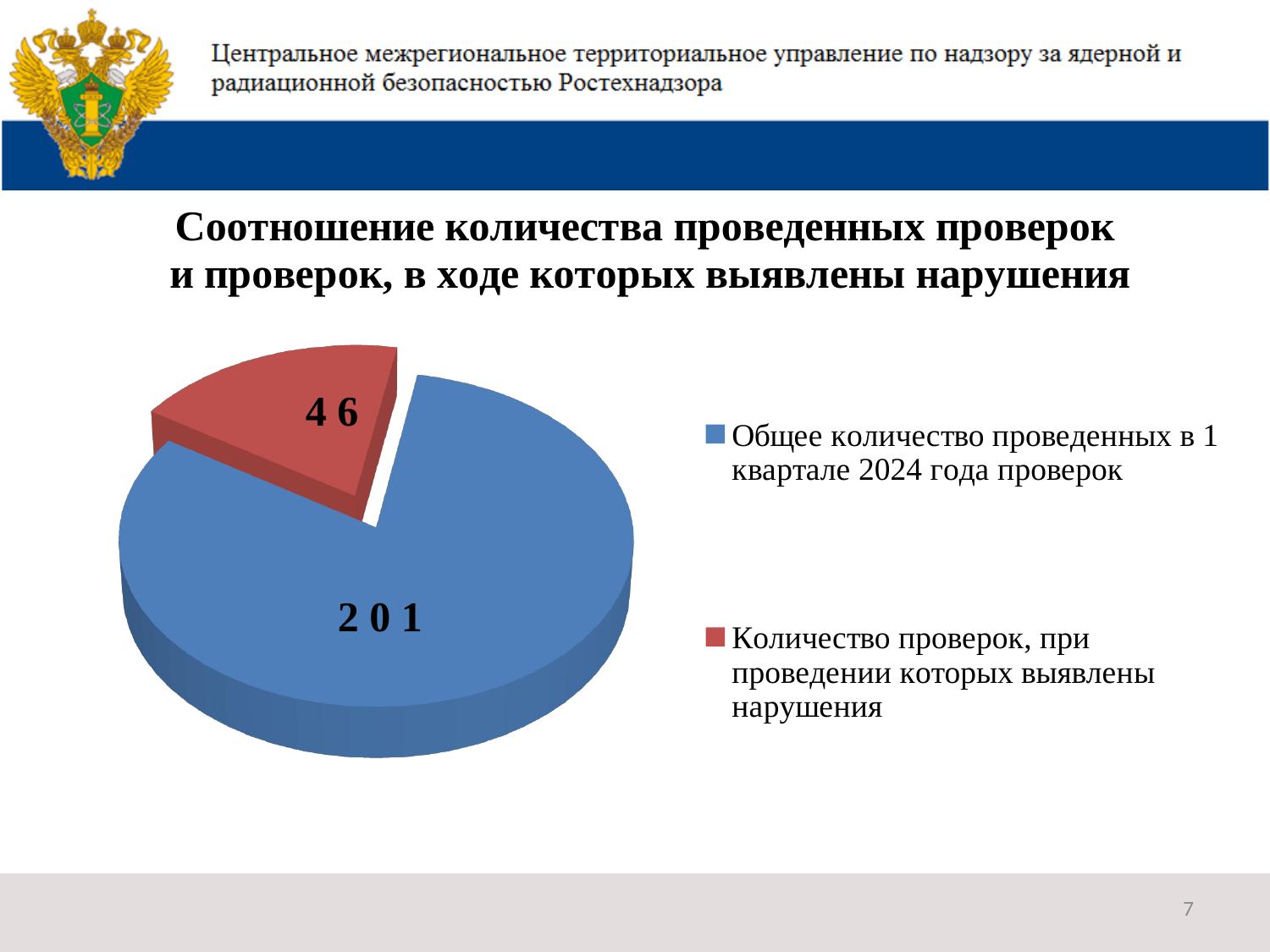
What is the value for "Количество проверок, при проведении которых выявлены нарушения"? 46 Which slice of the pie is the smallest? Количество проверок, при проведении которых выявлены нарушения Which is larger: the value for total inspections conducted in Q1 2024 or the value for inspections where violations were found? Общее количество проведенных в 1 квартале 2024 года проверок How many slices does the pie chart have? 2 What is the difference between the value for total inspections (201) and the value for inspections with violations (46)? 155 What type of chart is shown on the slide? pie chart What is the title of the chart on the slide? Соотношение количества проведенных проверок и проверок, в ходе которых выявлены нарушения Which slice of the pie is the largest? Общее количество проведенных в 1 квартале 2024 года проверок What colour is the slice for "Количество проверок, при проведении которых выявлены нарушения"? red What is the sum of the two values shown on the pie chart? 247 What is the value for "Общее количество проведенных в 1 квартале 2024 года проверок"? 201 How many entries does the legend list? 2